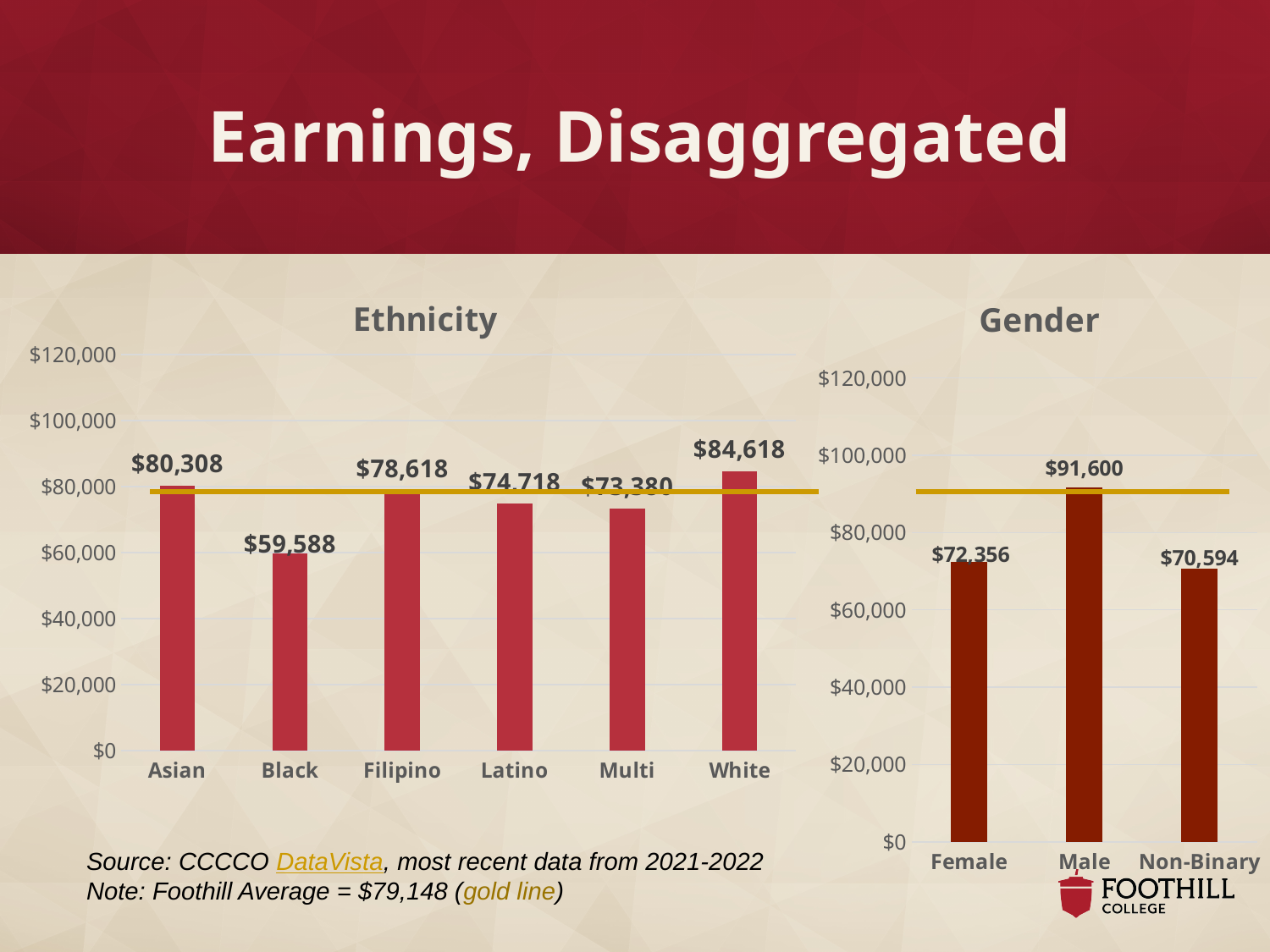
In the Gender chart, what is the difference between the earnings for Male and Female? $19,244 In the Ethnicity chart, which category has the lowest earnings? Black In the Ethnicity chart, which category has the highest earnings? White In the Ethnicity chart, what are the earnings for Black? $59,588 In the Ethnicity chart, what is the difference between the earnings for White and Black? $25,030 What type of chart is the Gender chart? Bar chart In the Gender chart, which category has the lowest earnings? Non-Binary In the Gender chart, what are the earnings for Non-Binary? $70,594 In the Ethnicity chart, how many ethnicity categories are shown? 6 In the Ethnicity chart, what are the earnings for Asian? $80,308 In the Gender chart, what are the earnings for Male? $91,600 In the Ethnicity chart, what are the earnings for Filipino? $78,618